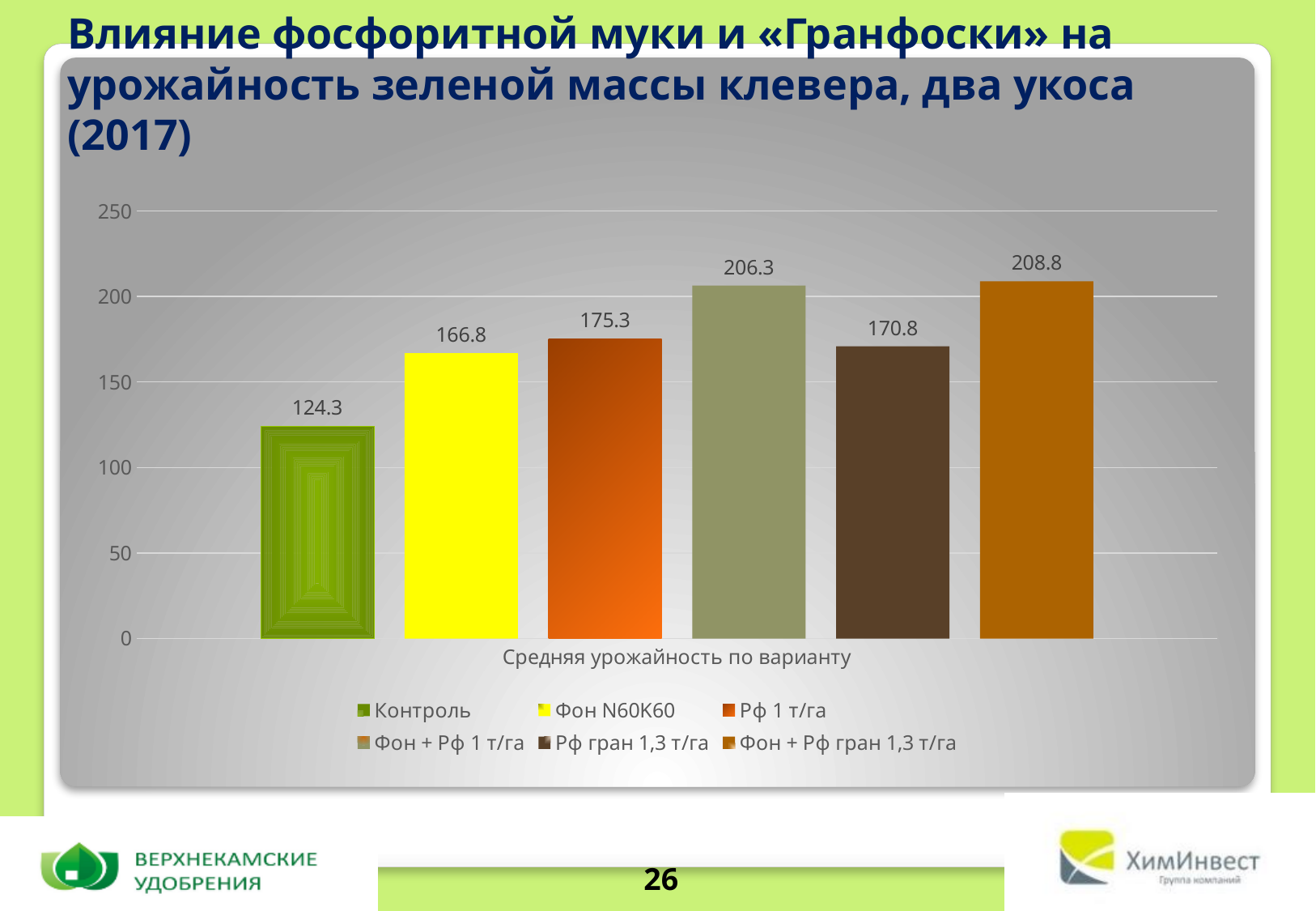
How many series does the legend list? 6 What is the value for Контроль? 124.3 What is the value for Фон + Рф 1 т/га? 206.3 What kind of chart is shown? bar chart What is the value for Рф гран 1,3 т/га? 170.8 What is the difference between Фон + Рф 1 т/га and Фон N60K60? 39.5 What is the difference between Фон + Рф гран 1,3 т/га and Контроль? 84.5 Which is larger, Рф 1 т/га or Рф гран 1,3 т/га? Рф 1 т/га Which series has the highest value? Фон + Рф гран 1,3 т/га Which series has the lowest value? Контроль What is the category label shown on the x axis? Средняя урожайность по варианту What is the value for Фон N60K60? 166.8